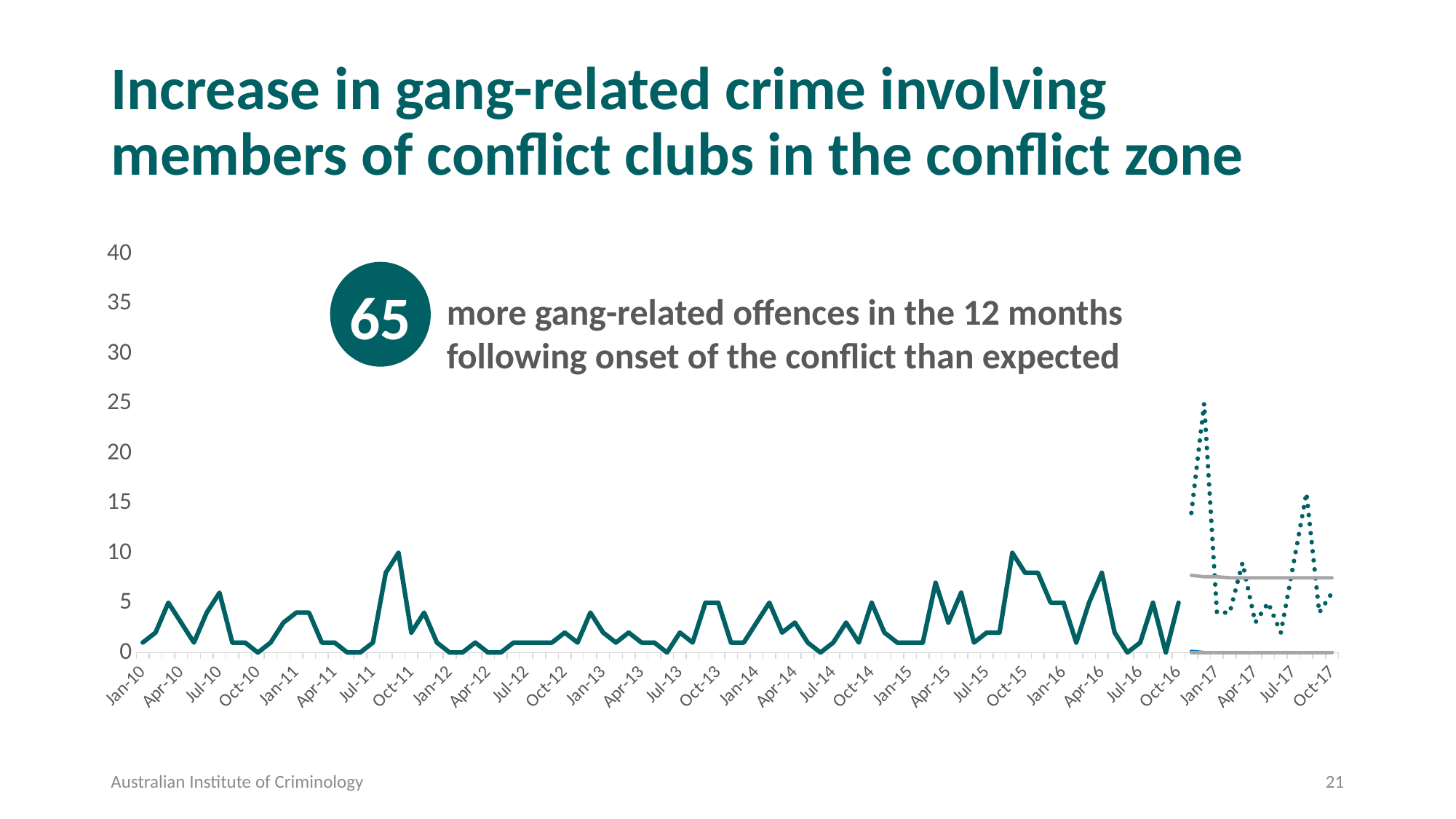
Is the peak of the dotted line near Jul-17 greater or less than 10? greater Is the highest point of the solid line (around Oct-15) greater or less than 15? less Which is higher: the dotted line near Jan-17 or the dotted line near Apr-17? near Jan-17 What is the highest value shown on the vertical axis? 40 What kind of chart is shown on the slide? line chart Is the value at Jan-10 greater or less than 5? less What number is printed in the teal circle above the chart? 65 Does the chart reach its highest point in the solid-line section or the dotted-line section? dotted-line section How many date labels are shown along the horizontal axis? 32 Does the dotted line rise or fall between Apr-17 and Jul-17? rise